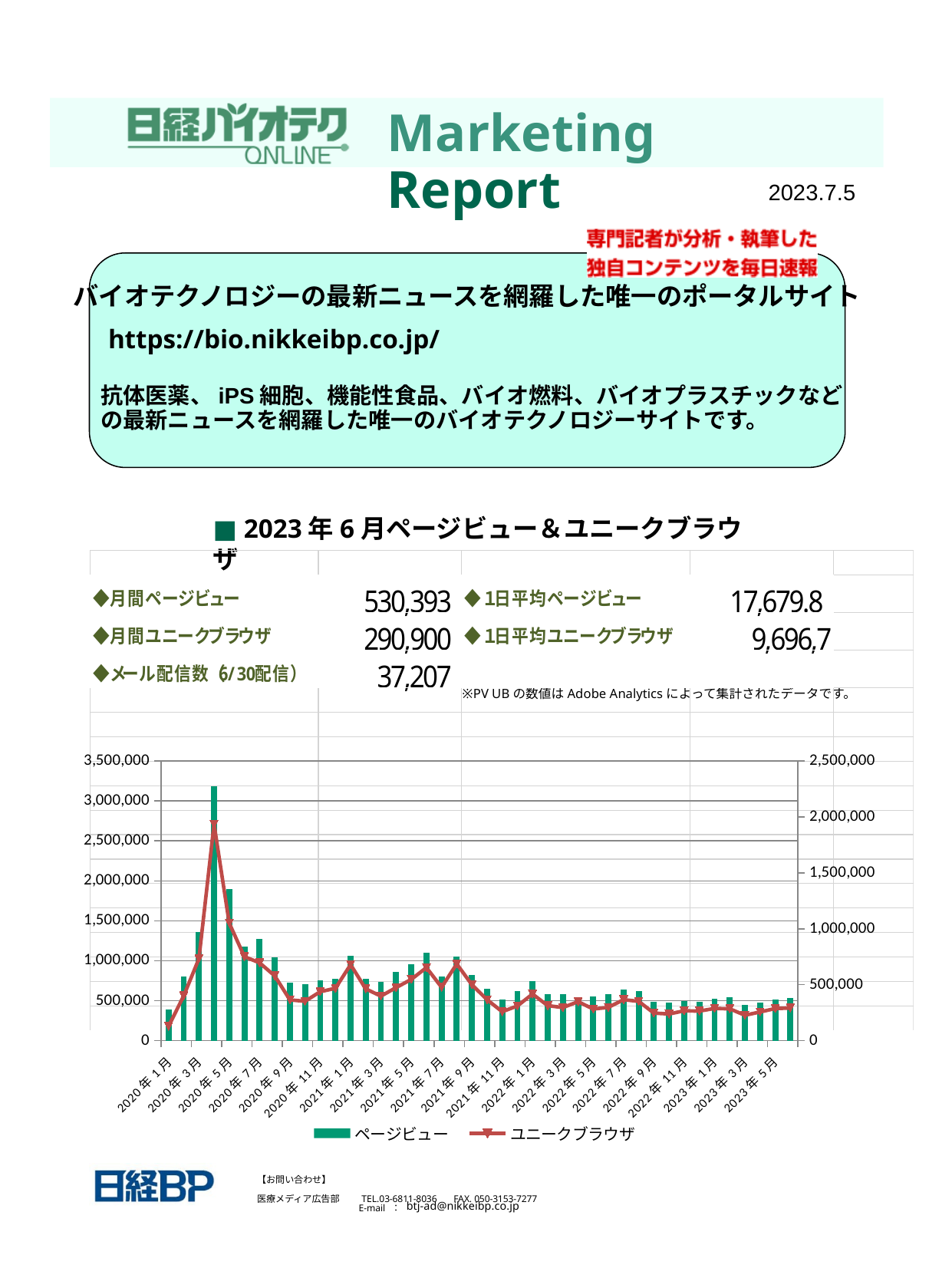
What are the two series named in the chart legend? ページビュー and ユニークブラウザ Overall, do page views rise or fall from 2020年4月 to 2023年6月? fall Which month has higher page views, 2020年4月 or 2020年5月? 2020年4月 In which month do the page views (ページビュー) reach their highest value? 2020年4月 Is the peak unique browser (ユニークブラウザ) value, read on the right axis, greater or less than 1,500,000? greater How many series does the chart legend list? 2 Is the page view value for 2023年5月 greater or less than 1,000,000? less Which month has higher page views, 2021年1月 or 2021年3月? 2021年1月 Which series is drawn as bars in the chart? ページビュー Is the page view value for 2020年4月 greater or less than 3,000,000? greater What kind of chart is shown on the slide? A combined bar and line chart